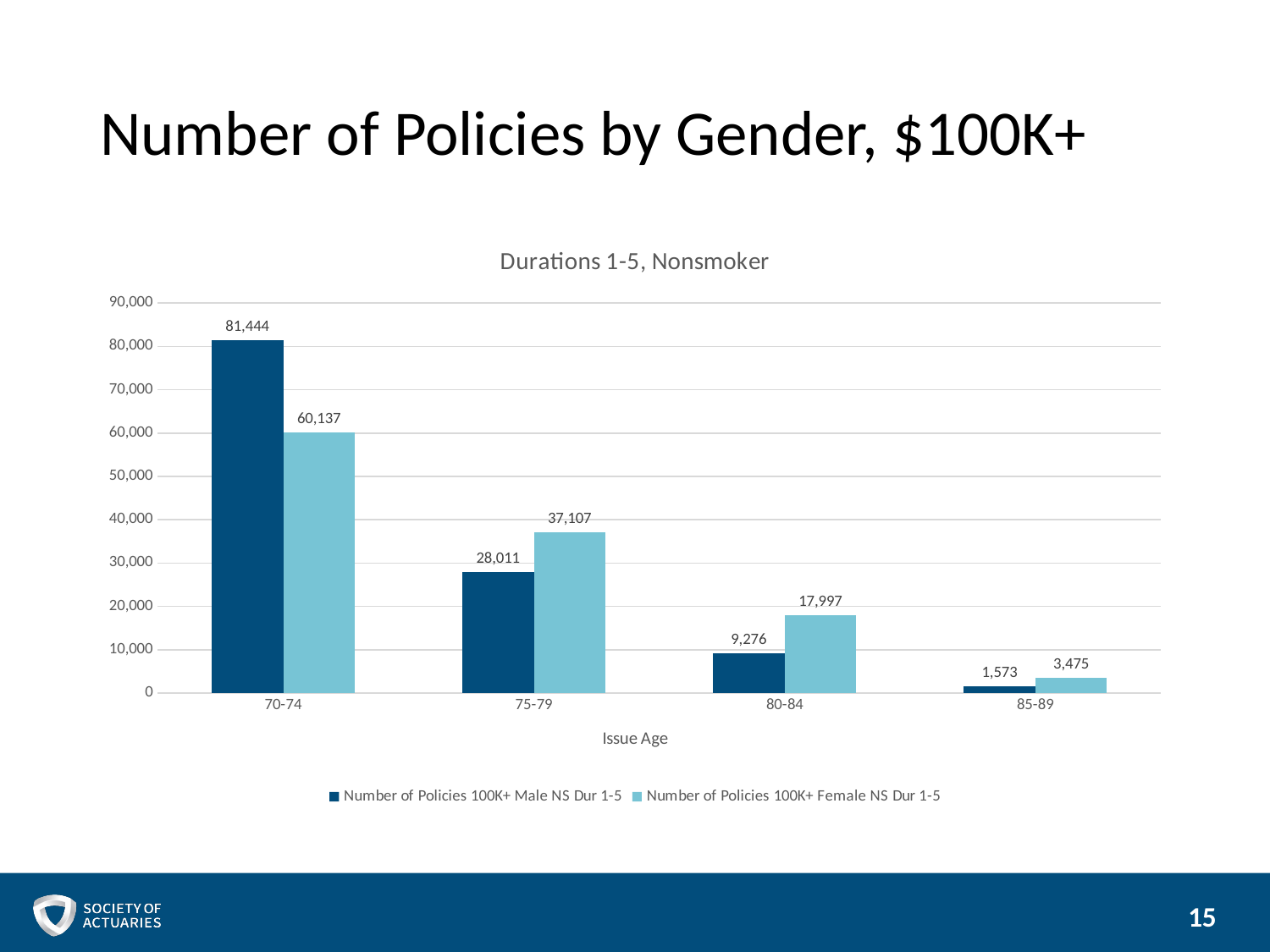
Do the Male NS Dur 1-5 policy counts rise or fall as issue age increases from 70-74 to 85-89? Fall What is the number of policies for Male NS Dur 1-5 at issue age 70-74? 81,444 Which issue age group has the highest number of policies for Female NS Dur 1-5? 70-74 What is the number of policies for Female NS Dur 1-5 at issue age 80-84? 17,997 What is the difference between the Male and Female NS Dur 1-5 policy counts at issue age 75-79? 9,096 How many issue age groups are shown on the x axis? 4 Is the number of policies for Female NS Dur 1-5 at issue age 70-74 greater or less than 50,000? greater How many series does the legend list? 2 At issue age 80-84, which is larger: the Male NS Dur 1-5 count or the Female NS Dur 1-5 count? Female NS Dur 1-5 Which issue age group has the lowest number of policies for Male NS Dur 1-5? 85-89 What is the number of policies for Male NS Dur 1-5 at issue age 85-89? 1,573 What kind of chart is shown on the slide? Bar chart